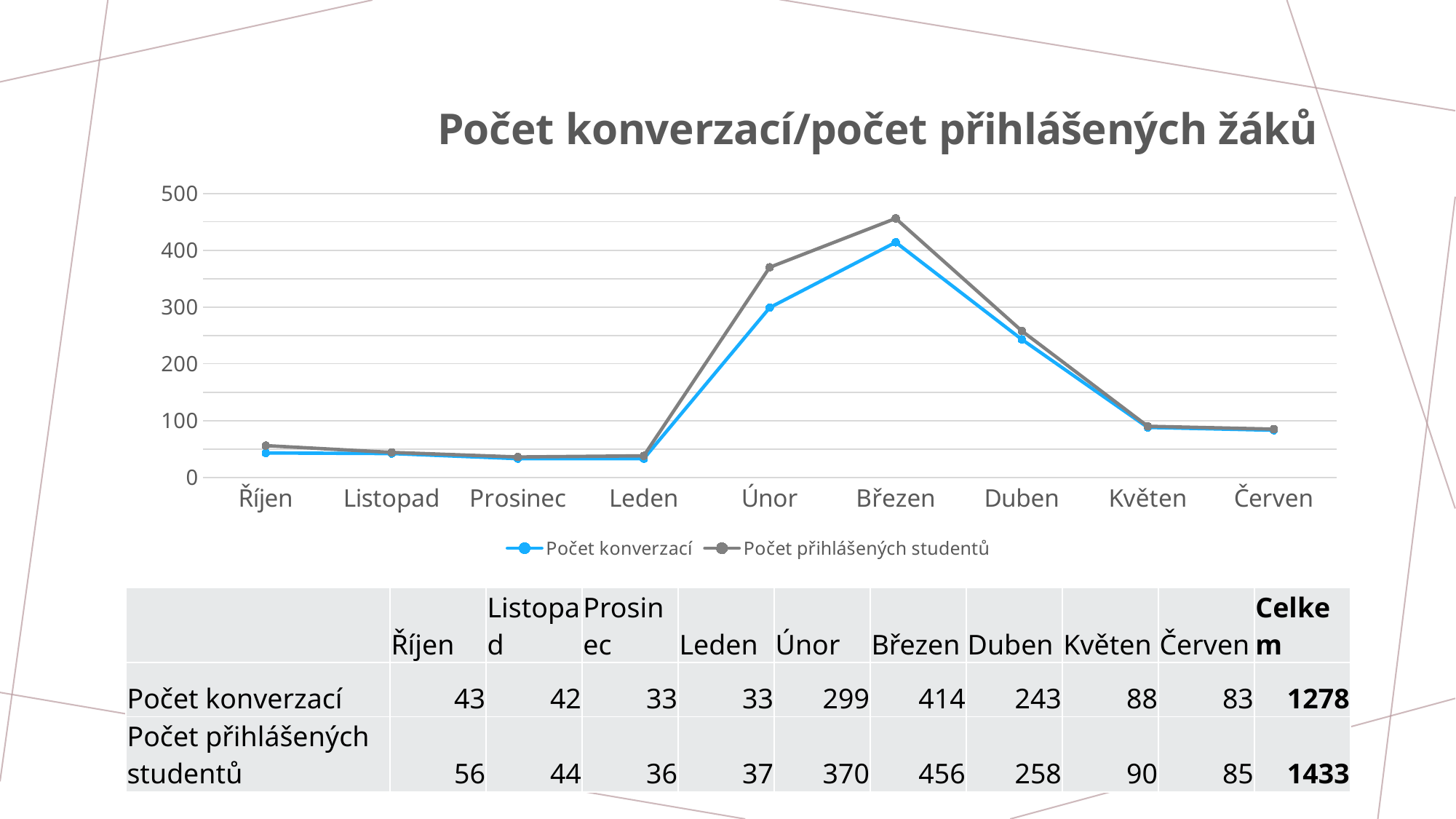
Which is larger in Duben: Počet konverzací or Počet přihlášených studentů? Počet přihlášených studentů What kind of chart is shown on the slide? line chart Do the values of Počet přihlášených studentů rise or fall from Březen to Červen? fall What is the value of Počet přihlášených studentů for Únor? 370 In which month is Počet přihlášených studentů highest? Březen Is the value of Počet konverzací for Únor greater or less than 200? greater What is the title of the chart? Počet konverzací/počet přihlášených žáků What is the value of Počet konverzací for Březen? 414 In which months is Počet konverzací lowest? Prosinec and Leden How many series does the chart legend list? 2 What is the difference between Počet přihlášených studentů and Počet konverzací in Březen? 42 How many months are plotted along the x axis of the chart? 9